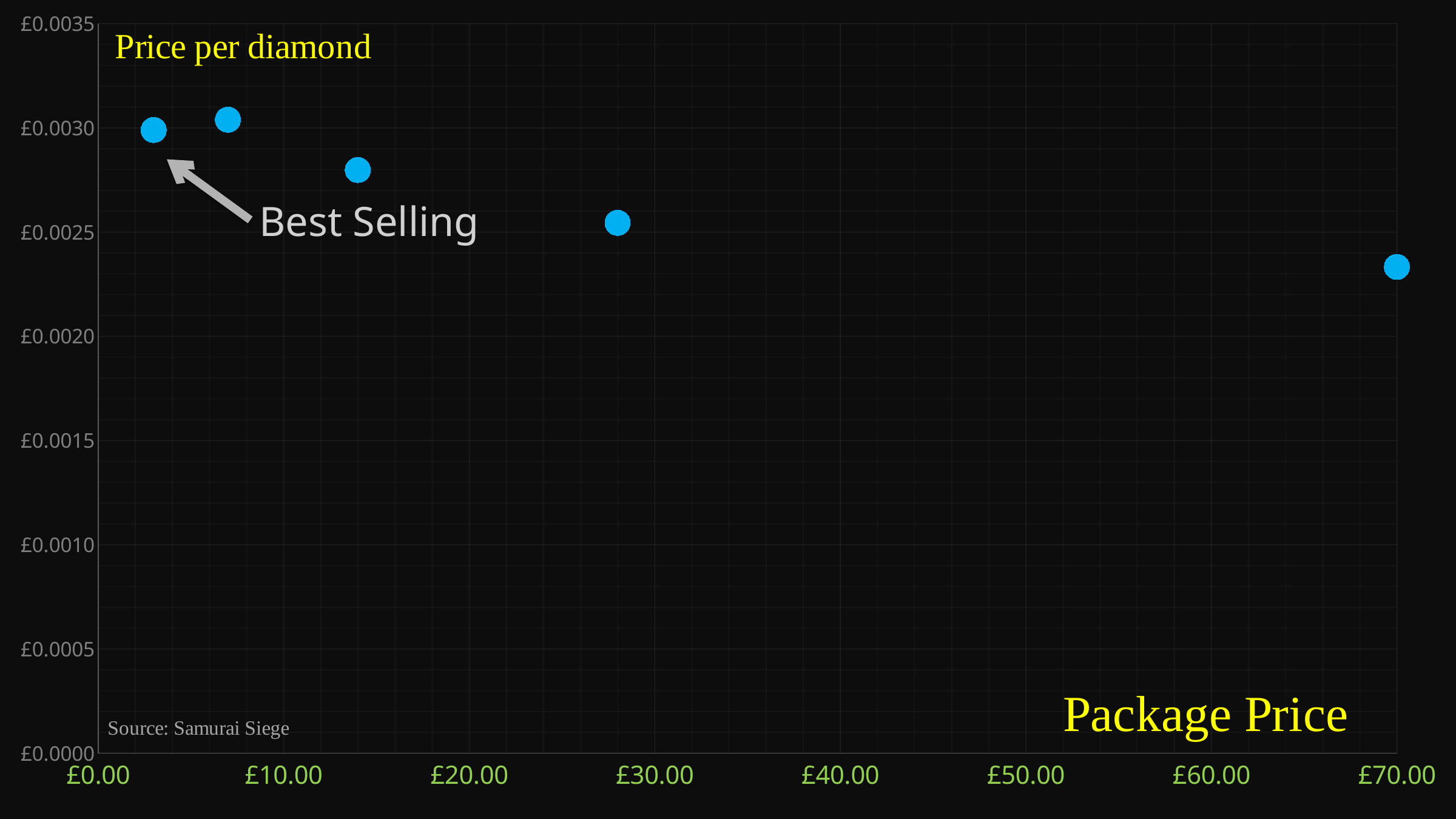
Which point does the 'Best Selling' arrow point to? the leftmost point What kind of chart is shown on the slide? scatter chart What label is shown on the x axis of the chart? Package Price Is the price per diamond for the point near £30.00 package price greater or less than £0.0020? greater How many data points are plotted on the chart? 5 Which point has the lowest price per diamond: the leftmost point or the rightmost point? the rightmost point Which has the higher price per diamond: the point near £30.00 package price or the point near £70.00 package price? the point near £30.00 Is the price per diamond for the point between £10.00 and £20.00 package price greater or less than £0.0030? less Is the price per diamond for the leftmost point greater or less than £0.0025? greater Does the price per diamond generally rise or fall as the package price increases? fall